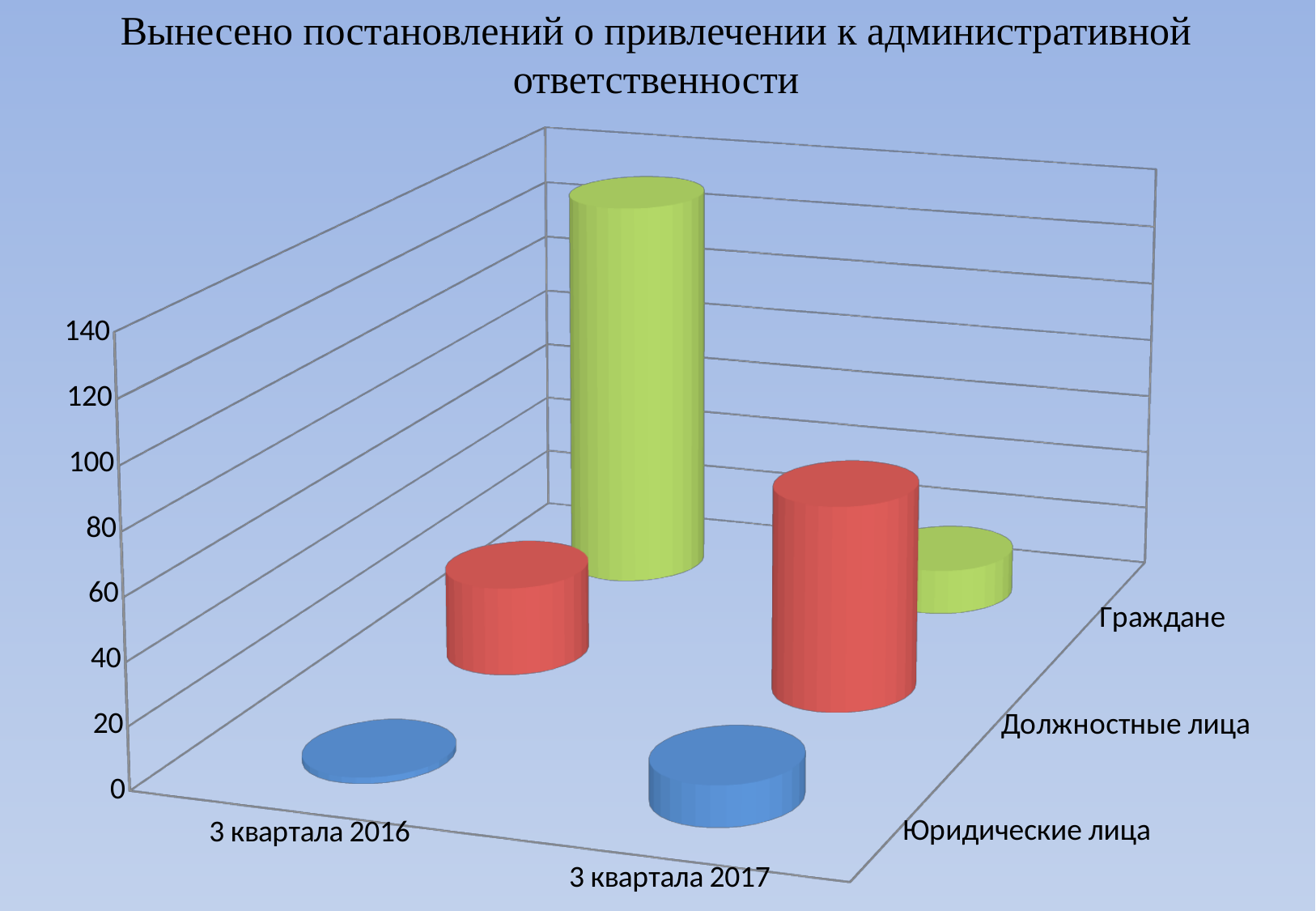
How many series (groups of persons) does the chart show? 3 How many time periods are shown along the x axis? 2 Which series and period has the highest bar on the chart? Граждане, 3 квартала 2016 Is the value for Граждане in 3 квартала 2016 greater or less than 100? greater What is the title of the chart? Вынесено постановлений о привлечении к административной ответственности For Граждане, which period has the larger value: 3 квартала 2016 or 3 квартала 2017? 3 квартала 2016 Is the value for Должностные лица in 3 квартала 2016 greater or less than 60? less Is the value for Юридические лица in 3 квартала 2016 greater or less than 20? less Which series and period has the lowest bar on the chart? Юридические лица, 3 квартала 2016 What kind of chart is shown on the slide? bar chart Does the value for Должностные лица rise or fall from 3 квартала 2016 to 3 квартала 2017? rise